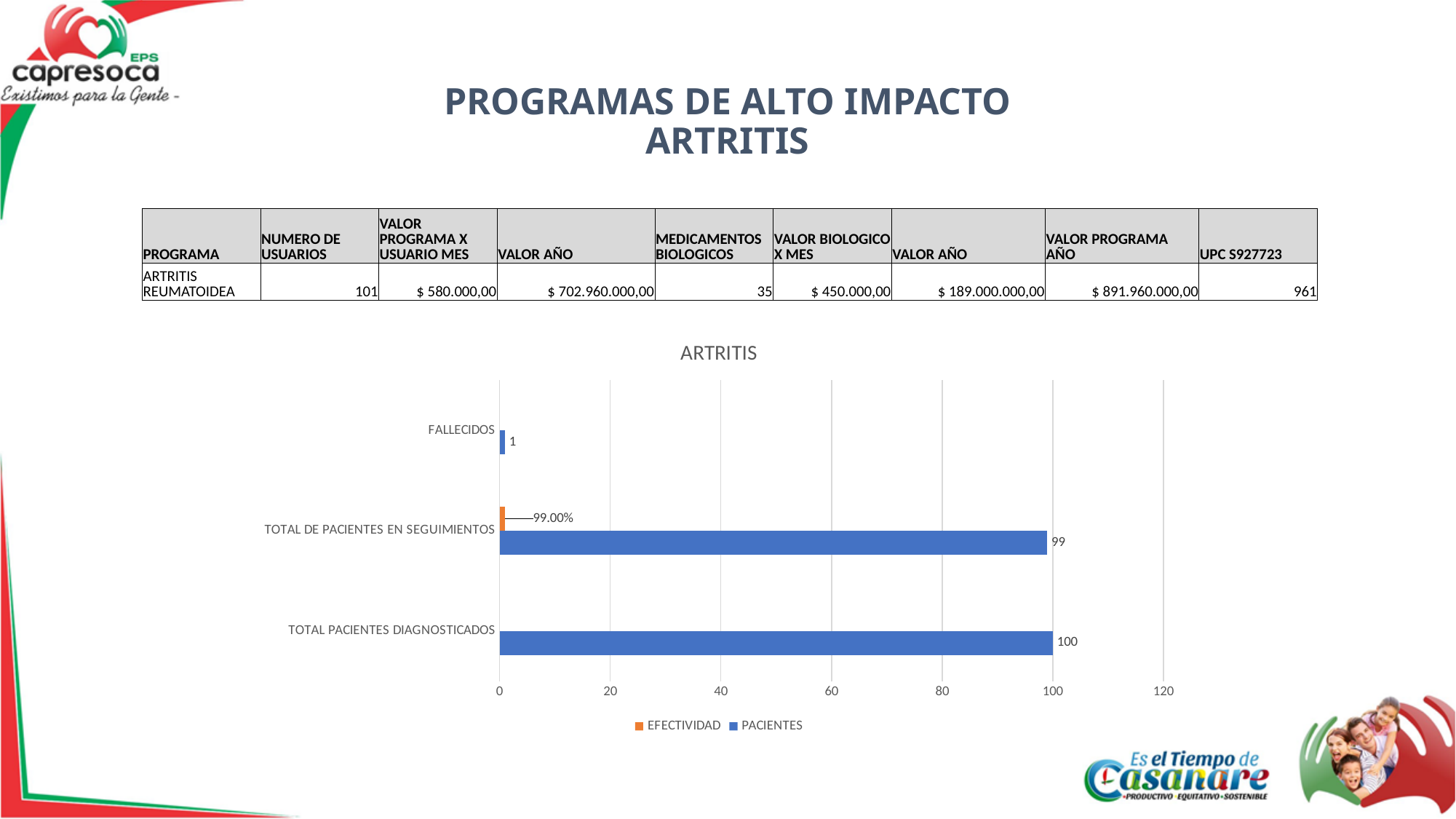
How many categories are shown on the vertical axis of the chart? 3 What EFECTIVIDAD value is labelled for TOTAL DE PACIENTES EN SEGUIMIENTOS? 99.00% What is the PACIENTES value for FALLECIDOS? 1 What is the PACIENTES value for TOTAL DE PACIENTES EN SEGUIMIENTOS? 99 What is the PACIENTES value for TOTAL PACIENTES DIAGNOSTICADOS? 100 Which is larger: the PACIENTES value for TOTAL DE PACIENTES EN SEGUIMIENTOS or for FALLECIDOS? TOTAL DE PACIENTES EN SEGUIMIENTOS Which category has the lowest PACIENTES value? FALLECIDOS How many series does the chart legend list? 2 What is the difference between the PACIENTES values for TOTAL PACIENTES DIAGNOSTICADOS and TOTAL DE PACIENTES EN SEGUIMIENTOS? 1 What type of chart is shown under the title ARTRITIS? bar chart Which category has the highest PACIENTES value? TOTAL PACIENTES DIAGNOSTICADOS What is the title of the chart? ARTRITIS